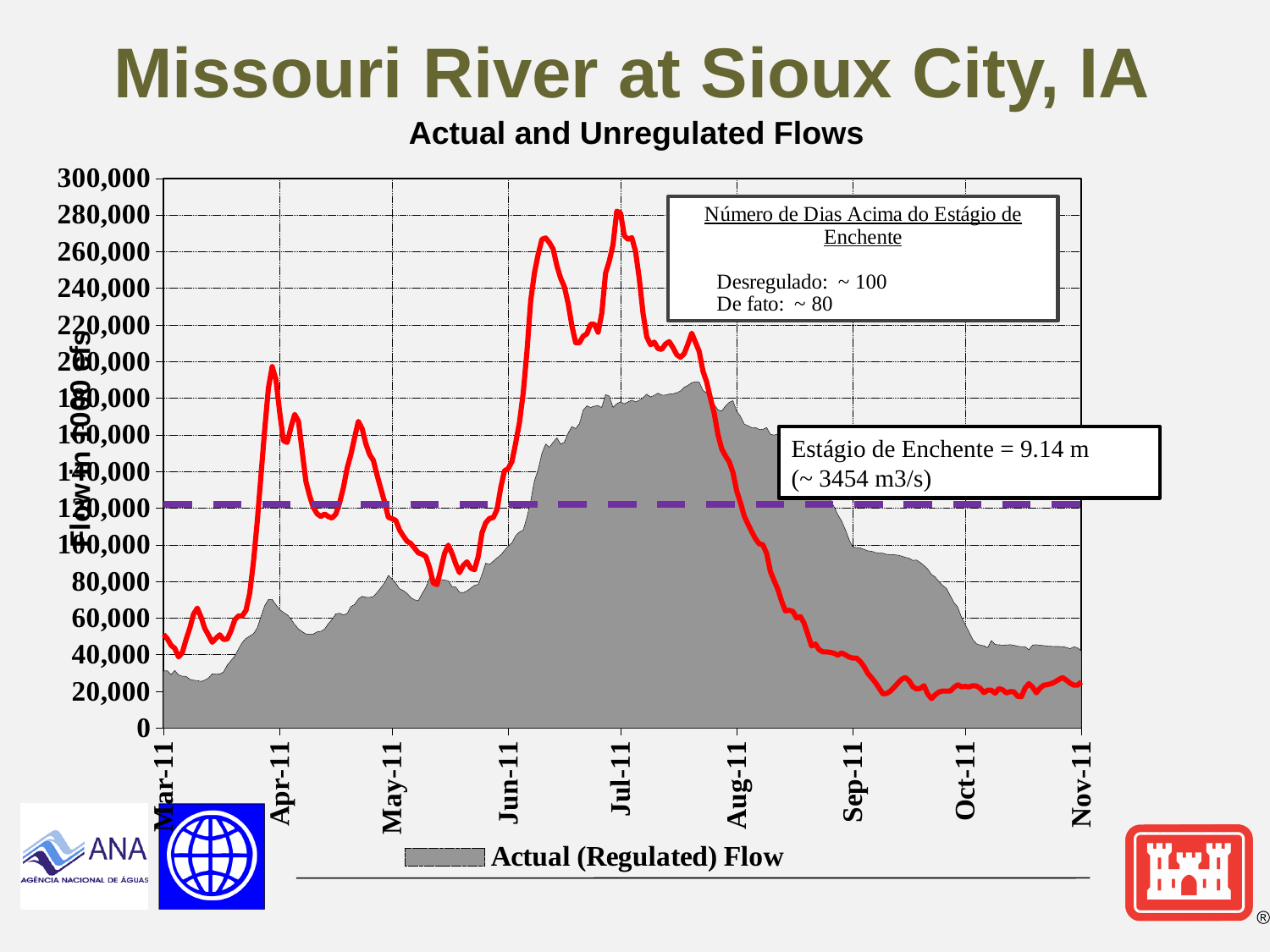
What series is named in the legend? Actual (Regulated) Flow At Oct-11, which is higher: the red line or the Actual (Regulated) Flow? Actual (Regulated) Flow Does the Actual (Regulated) Flow rise or fall from Aug-11 to Nov-11? Fall What kind of chart is shown on the slide? Area chart with a line Is the red line's value at Nov-11 greater or less than 40,000? less Is the peak value of the Actual (Regulated) Flow greater or less than 160,000? greater At Jul-11, which is higher: the red line or the Actual (Regulated) Flow? The red line Is the Actual (Regulated) Flow at Jul-11 greater or less than 140,000? greater How many month labels are shown on the x axis? 9 How many series does the legend list? 1